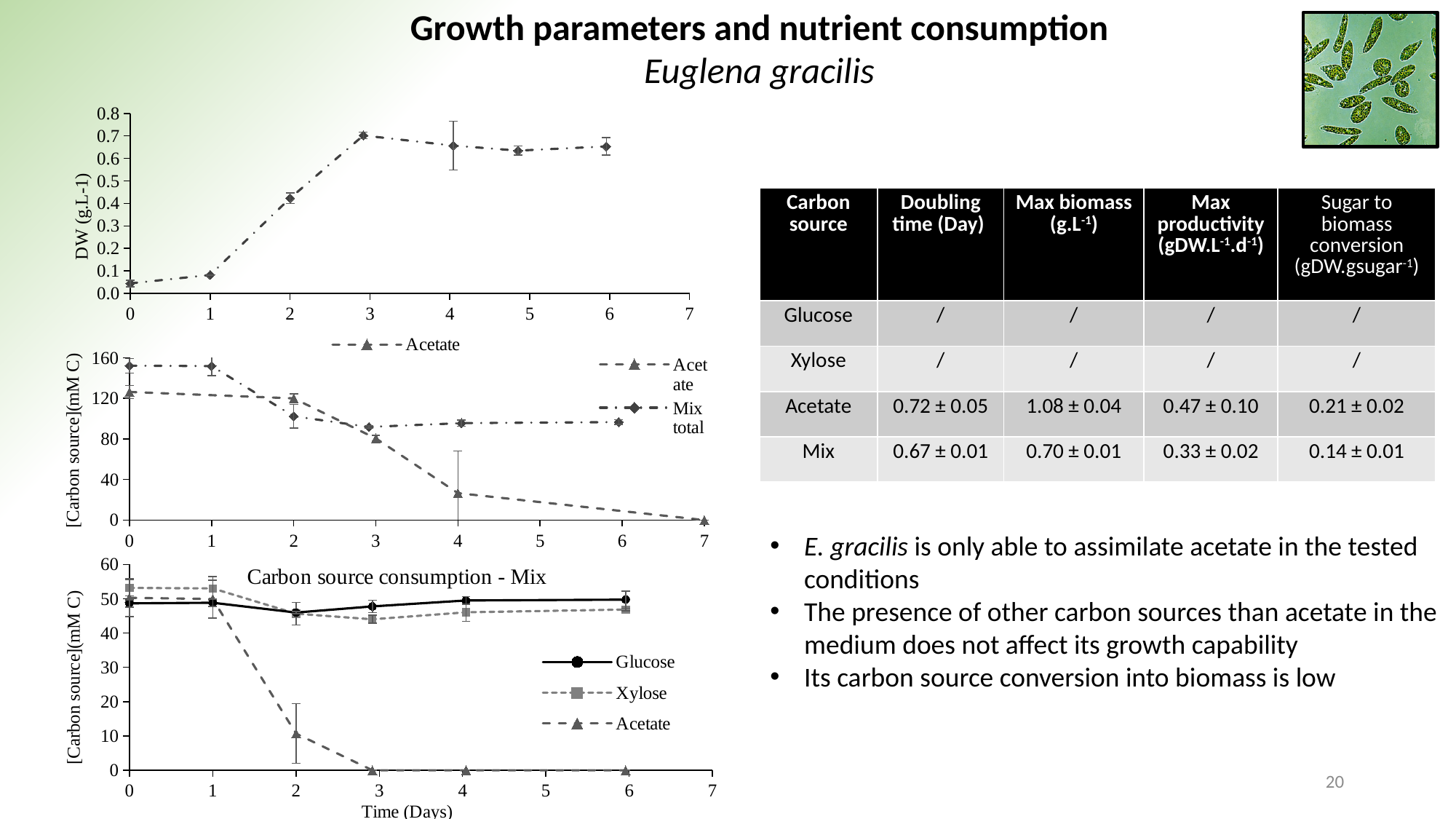
How many series does the legend of the chart titled 'Carbon source consumption - Mix' list? 3 How many series does the legend of the middle-left chart list? 2 In the chart titled 'Carbon source consumption - Mix', is the Glucose value at day 6 greater or less than 40? greater In the top-left chart (DW g.L-1), is the value at day 2 greater or less than 0.5? less What kind of chart is the top-left chart showing DW (g.L-1) over time? line chart In the middle-left chart, does the Acetate series rise or fall from day 0 to day 7? fall In the top-left chart (DW g.L-1), is the value at day 3 greater or less than 0.6? greater How many data points are plotted in the top-left chart (DW g.L-1)? 7